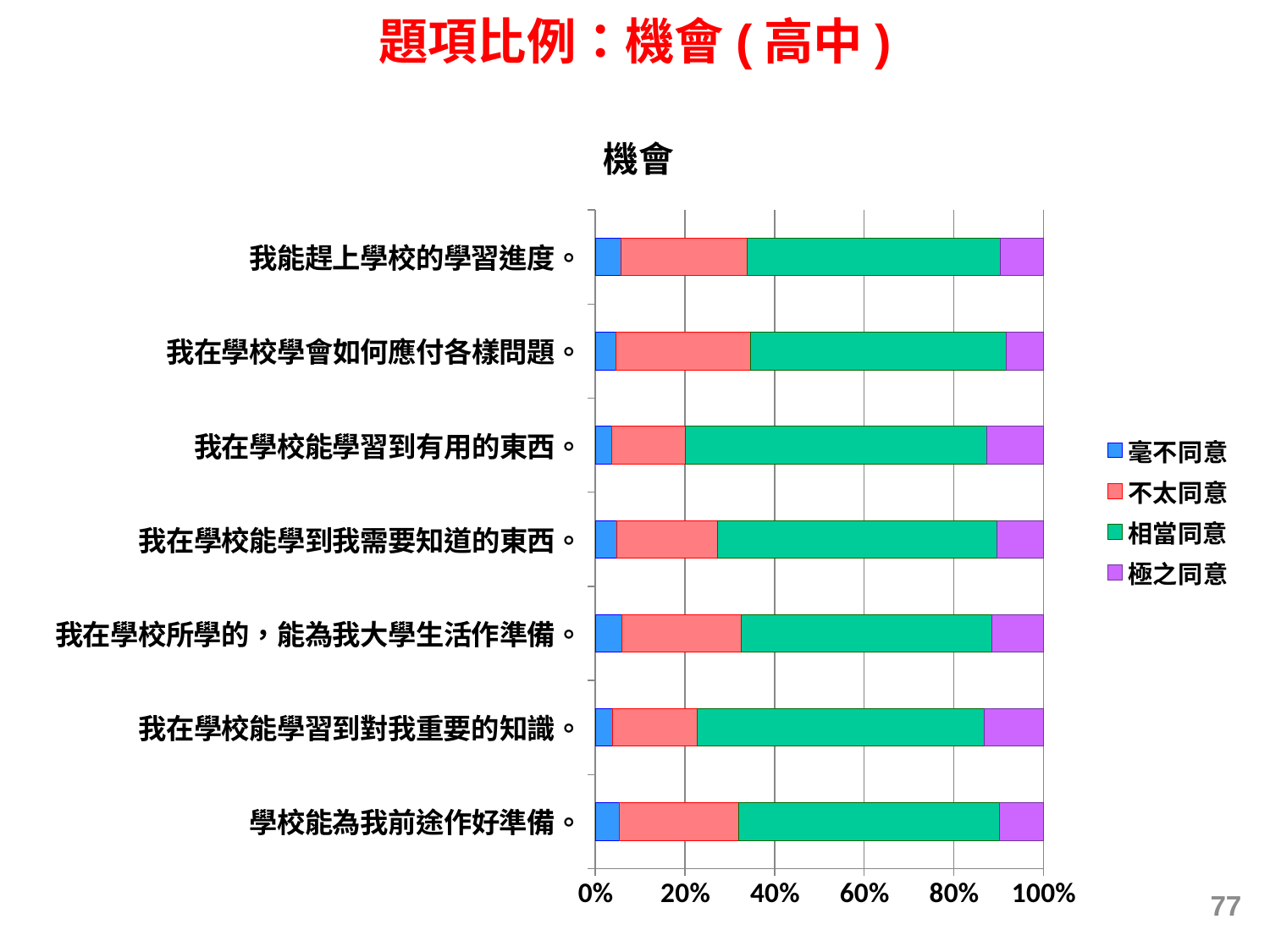
For 我在學校能學習到有用的東西, which is larger: the 相當同意 segment or the 不太同意 segment? 相當同意 What is the title of the chart? 機會 For 我能趕上學校的學習進度, is the combined share of 毫不同意 and 不太同意 greater or less than 40%? less For 我能趕上學校的學習進度, which is larger: the 毫不同意 segment or the 極之同意 segment? 極之同意 What is the total of the stacked bar for 學校能為我前途作好準備? 100% For 我在學校學會如何應付各樣問題, is the 極之同意 segment greater or less than 20%? less How many statements (categories) are plotted on the chart? 7 For 我在學校能學到我需要知道的東西, is the 相當同意 segment greater or less than 40%? greater Which series occupies the largest portion of every bar in the chart? 相當同意 How many series does the legend list? 4 What kind of chart is shown on the slide? Stacked bar chart Which legend entry is shown in green? 相當同意